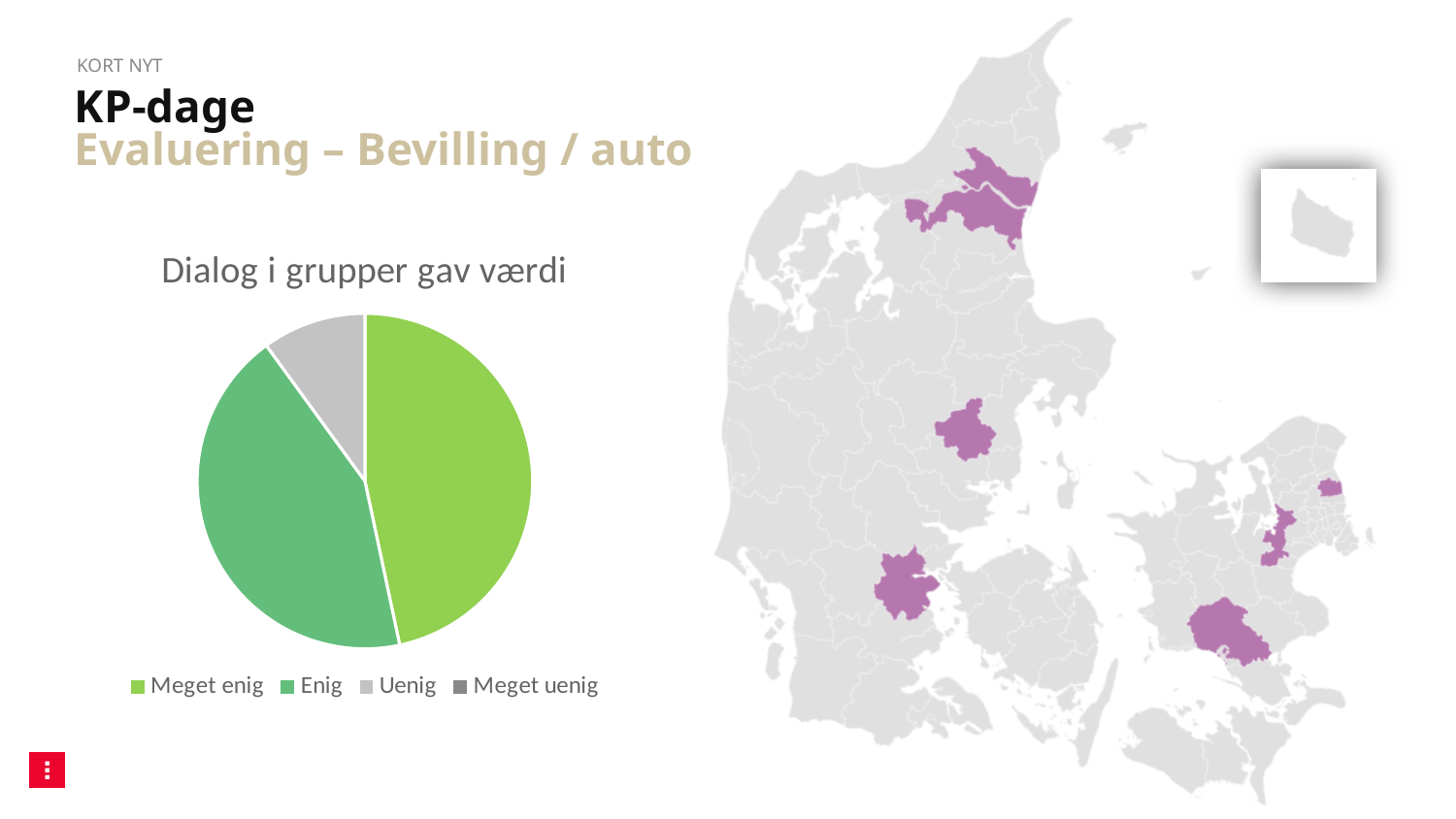
Is the share of the Uenig slice in the pie chart greater or less than 25%? less What is the title of the pie chart? Dialog i grupper gav værdi Is the share of the Enig slice in the pie chart greater or less than 25%? greater What kind of chart is shown on the slide? Pie chart How many categories does the legend of the pie chart list? 4 Which is larger in the pie chart, the slice for Enig or the slice for Uenig? Enig Which is larger in the pie chart, the slice for Meget enig or the slice for Uenig? Meget enig Which colour represents Meget enig in the pie chart? Light green